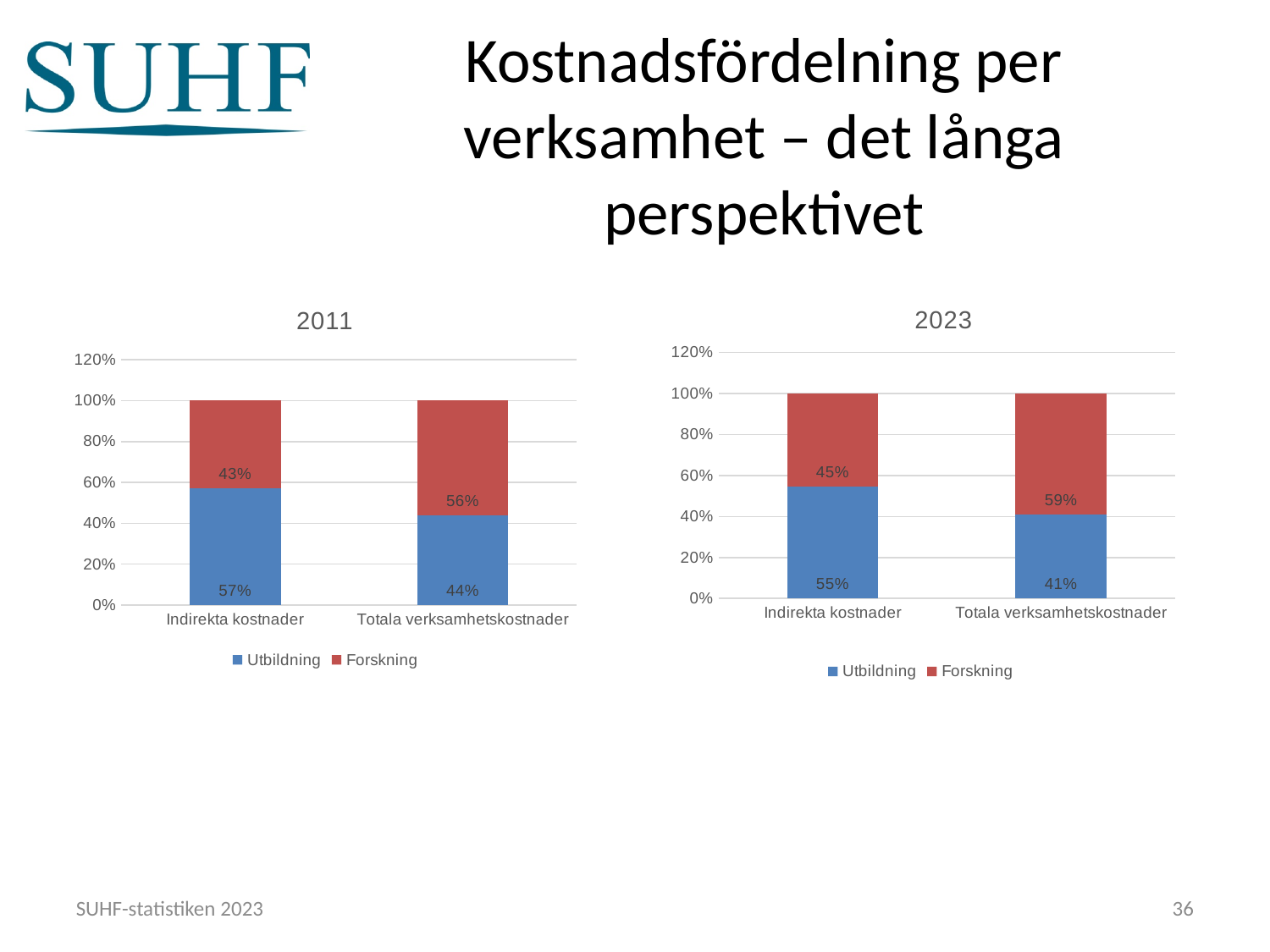
In the 2011 chart, what is the difference between the Utbildning and Forskning values for Indirekta kostnader? 14% In the 2011 chart, which category has the highest Utbildning value? Indirekta kostnader In the 2023 chart, which is larger for Totala verksamhetskostnader, Utbildning or Forskning? Forskning What kind of chart is the 2023 chart? Stacked bar chart In the 2023 chart, what is the value for Utbildning in Totala verksamhetskostnader? 41% In the 2011 chart, what is the value for Utbildning in Indirekta kostnader? 57% How many series does the legend of the 2011 chart list? 2 In the 2011 chart, what is the value for Forskning in Totala verksamhetskostnader? 56% In the 2023 chart, which category has the lowest Forskning value? Indirekta kostnader In the 2023 chart, what is the total of the stacked bar for Indirekta kostnader? 100% In the 2023 chart, what is the value for Forskning in Indirekta kostnader? 45% How many categories are shown on the x axis of the 2023 chart? 2